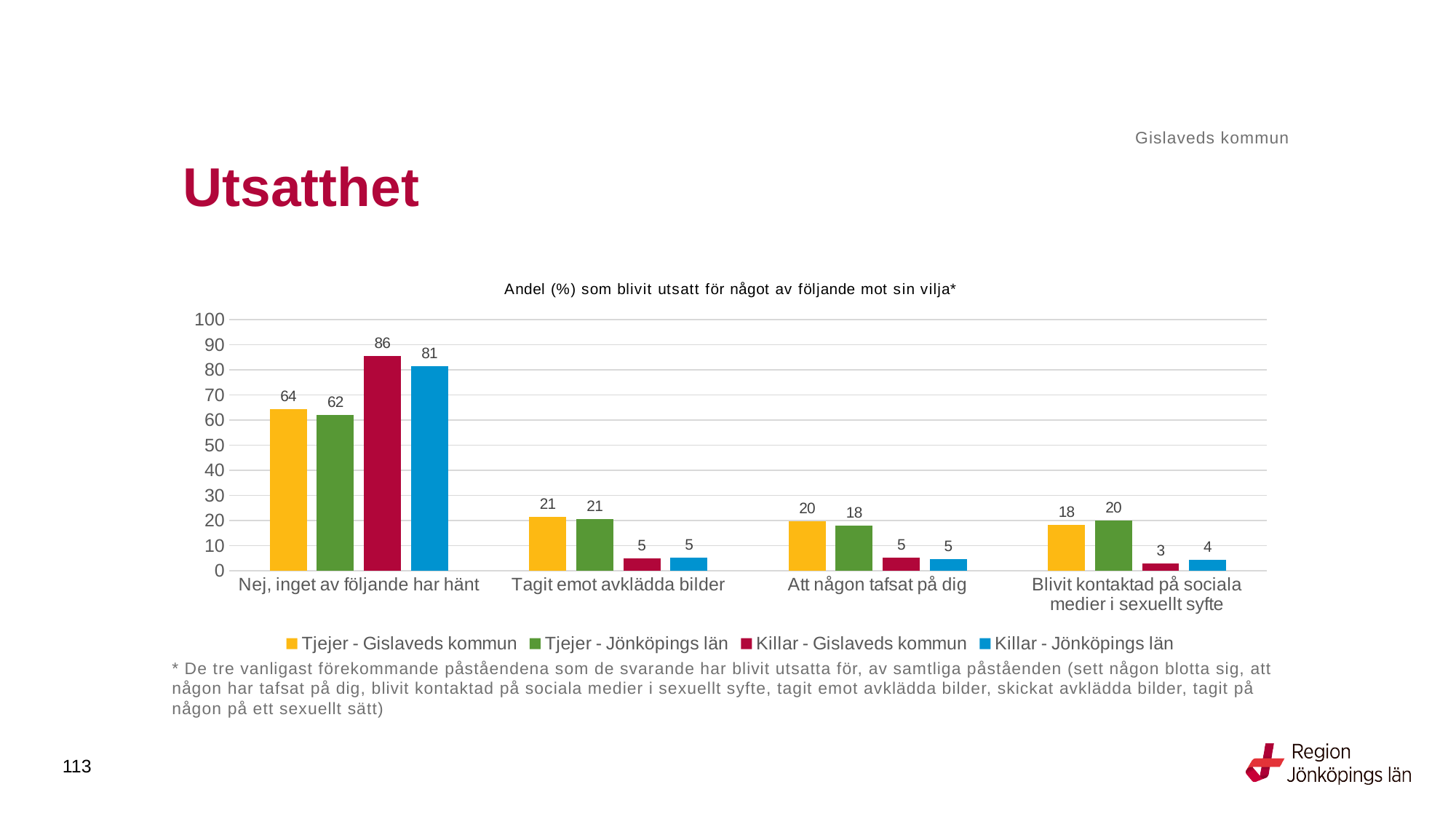
What is the difference between Killar - Gislaveds kommun and Tjejer - Gislaveds kommun in the category 'Nej, inget av följande har hänt'? 22 Which is larger in the category 'Att någon tafsat på dig': Tjejer - Gislaveds kommun or Tjejer - Jönköpings län? Tjejer - Gislaveds kommun Which series has the highest value in the category 'Nej, inget av följande har hänt'? Killar - Gislaveds kommun How many series does the legend list? 4 What kind of chart is shown on the slide? Bar chart What is the title of the chart? Andel (%) som blivit utsatt för något av följande mot sin vilja* Which series has the lowest value in the category 'Blivit kontaktad på sociala medier i sexuellt syfte'? Killar - Gislaveds kommun How many categories are shown on the x axis? 4 What is the value for Killar - Gislaveds kommun in the category 'Nej, inget av följande har hänt'? 86 Is the value for Killar - Jönköpings län in 'Nej, inget av följande har hänt' greater or less than 70? greater What is the value for Tjejer - Jönköpings län in the category 'Tagit emot avklädda bilder'? 21 What is the value for Killar - Jönköpings län in the category 'Blivit kontaktad på sociala medier i sexuellt syfte'? 4